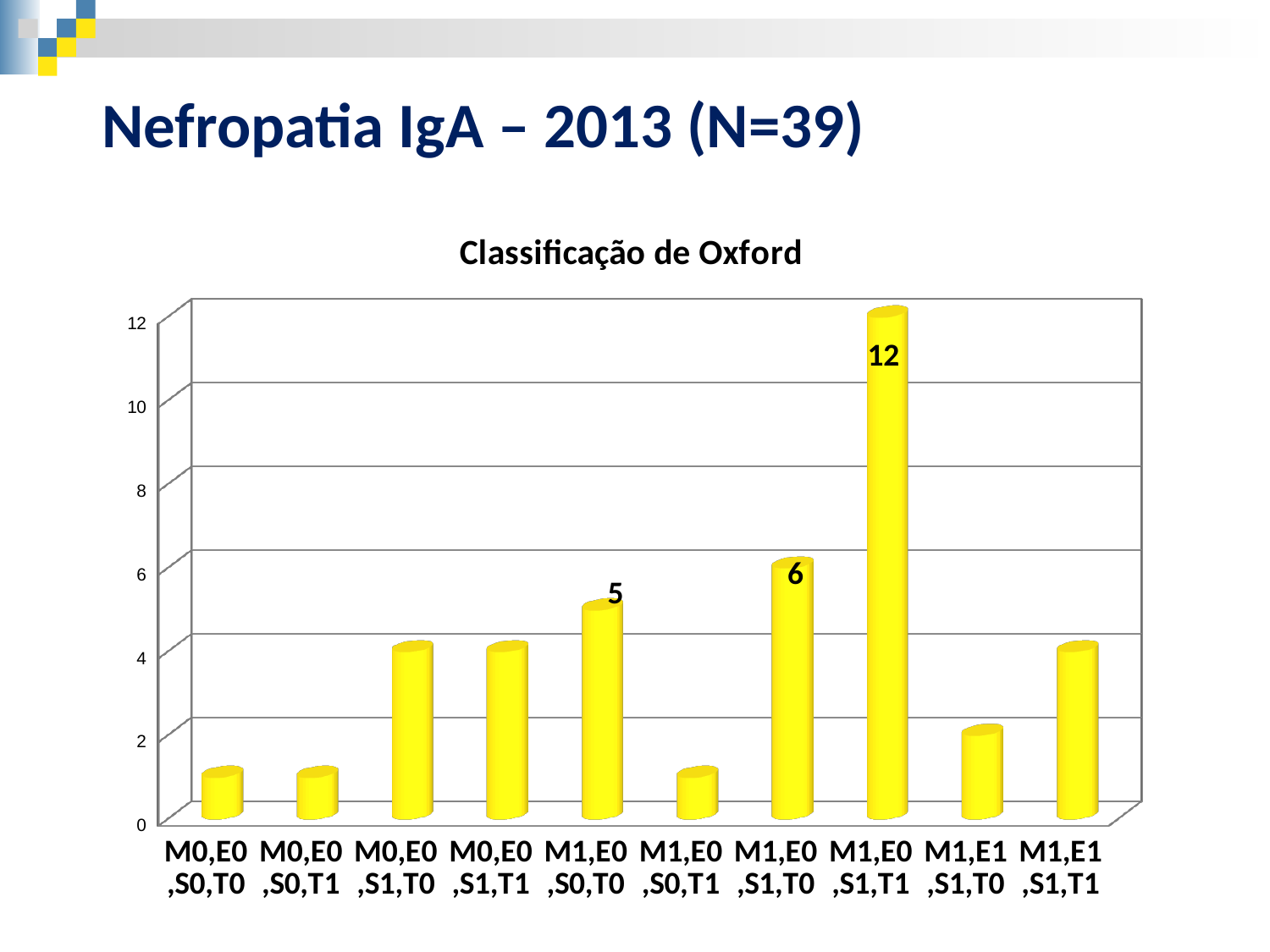
Is the value for M1,E1,S1,T0 greater or less than 4? less What is the value for M1,E0,S0,T0? 5 How many categories are shown on the x axis? 10 What is the value for M1,E0,S1,T1 in the Classificação de Oxford chart? 12 Is the value for M0,E0,S0,T0 greater or less than 2? less Which is larger, the value for M1,E0,S0,T0 or the value for M1,E0,S1,T0? M1,E0,S1,T0 What kind of chart is shown on the slide? Bar chart Which category has the highest value? M1,E0,S1,T1 What is the value for M1,E0,S1,T0? 6 Is the value for M0,E0,S1,T0 greater or less than 2? greater What is the difference between the values for M1,E0,S1,T1 and M1,E0,S1,T0? 6 What is the difference between the values for M1,E0,S1,T0 and M1,E0,S0,T0? 1